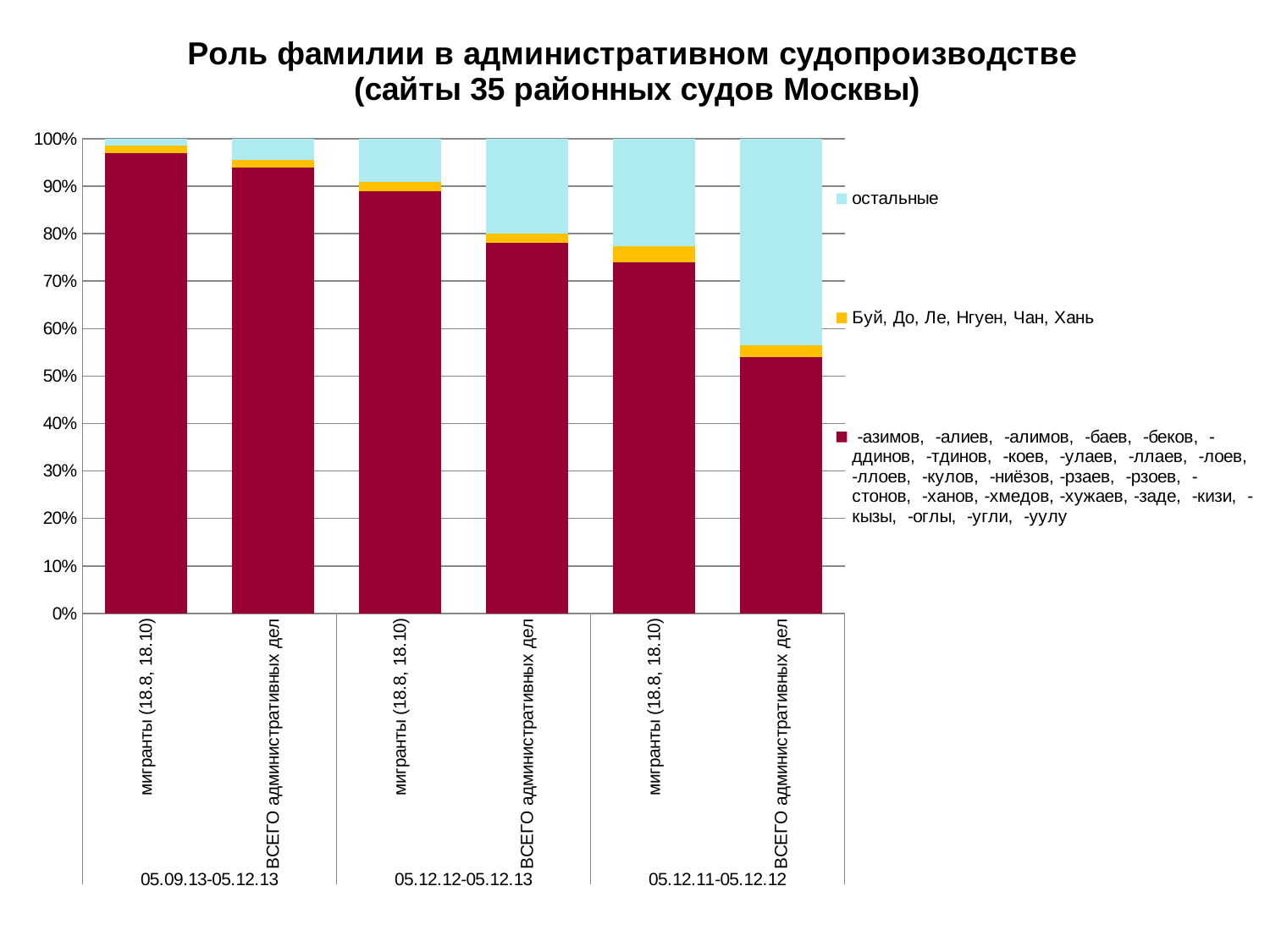
In the period 05.12.11-05.12.12, which bar has the larger 'остальные' share: 'мигранты (18.8, 18.10)' or 'ВСЕГО административных дел'? ВСЕГО административных дел Which bar has the smallest dark red share? ВСЕГО административных дел, 05.12.11-05.12.12 Is the dark red share for 'ВСЕГО административных дел' in the period 05.12.11-05.12.12 greater or less than 60%? less Which legend entry is shown in light blue? остальные Is the dark red share for 'ВСЕГО административных дел' in the period 05.12.12-05.12.13 greater or less than 80%? less How many series does the legend list? 3 Is the dark red share for 'мигранты (18.8, 18.10)' in the period 05.12.11-05.12.12 greater or less than 70%? greater What kind of chart is shown on the slide? stacked bar chart How many bars are plotted in the chart? 6 What is the top line of the chart title? Роль фамилии в административном судопроизводстве How many time periods are shown along the x axis? 3